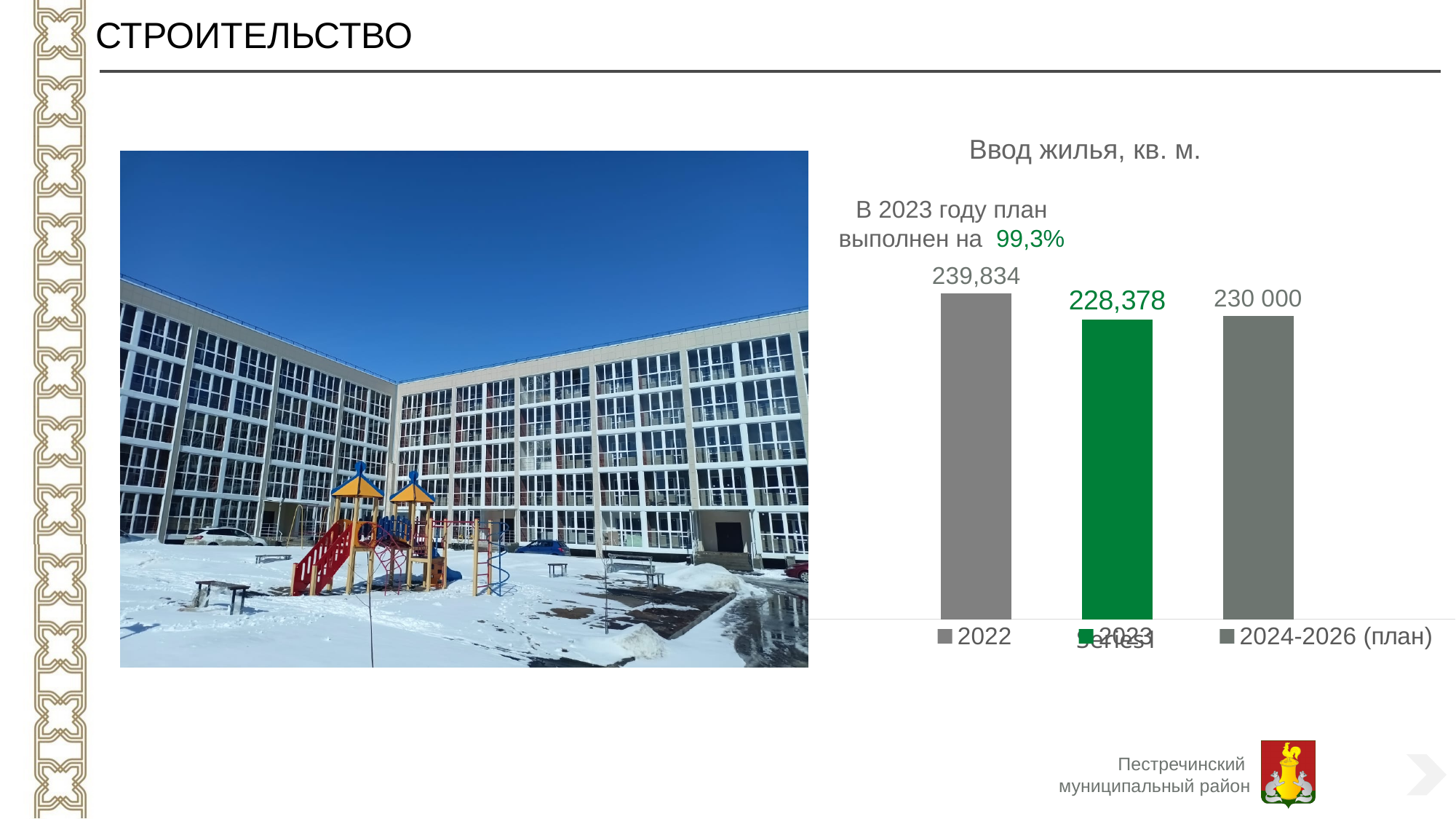
Does the value rise or fall from 2022 to 2023? fall What type of chart is shown on the slide? bar chart Which is larger: the value for 2022 or the value for 2024-2026 (план)? 2022 What is the value for 2023 in the chart? 228,378 What is the value for 2022 in the chart? 239,834 Which category has the lowest value in the chart? 2023 What is the difference between the values for 2024-2026 (план) and 2023? 1,622 What is the value for 2024-2026 (план) in the chart? 230 000 What is the difference between the values for 2022 and 2023? 11,456 What is the title of the chart on the slide? Ввод жилья, кв. м. How many bars does the chart show? 3 Which category has the highest value in the chart? 2022